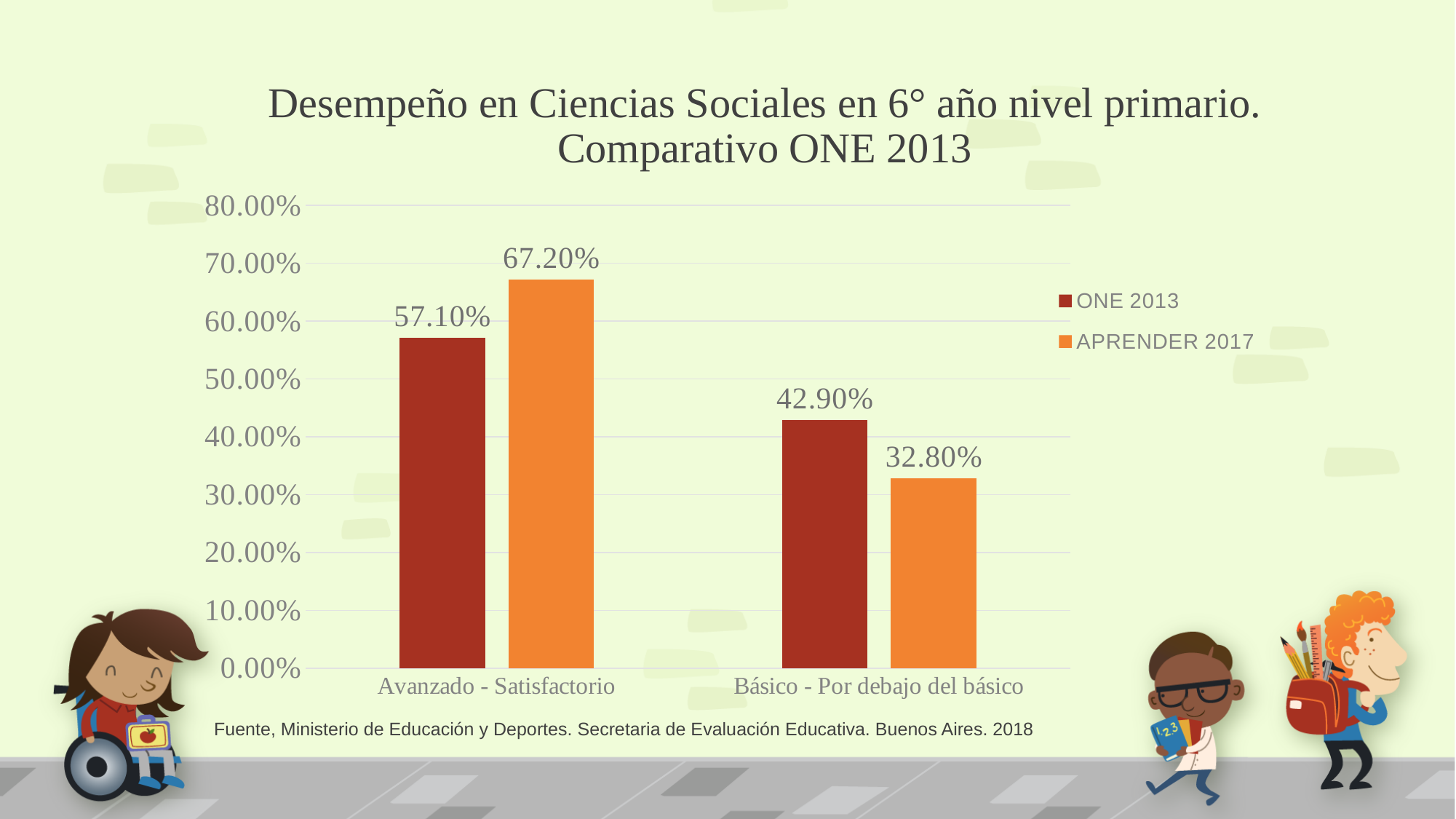
What is the difference between the APRENDER 2017 and ONE 2013 values for Avanzado - Satisfactorio? 10.10% What is the ONE 2013 value for Avanzado - Satisfactorio? 57.10% What is the difference between the ONE 2013 and APRENDER 2017 values for Básico - Por debajo del básico? 10.10% How many categories are shown on the x axis? 2 What is the APRENDER 2017 value for Avanzado - Satisfactorio? 67.20% Which bar has the highest value on the chart? APRENDER 2017, Avanzado - Satisfactorio What kind of chart is shown on the slide? Bar chart Which bar has the lowest value on the chart? APRENDER 2017, Básico - Por debajo del básico What is the ONE 2013 value for Básico - Por debajo del básico? 42.90% How many series does the legend list? 2 What is the APRENDER 2017 value for Básico - Por debajo del básico? 32.80% For Básico - Por debajo del básico, which series has the larger value, ONE 2013 or APRENDER 2017? ONE 2013